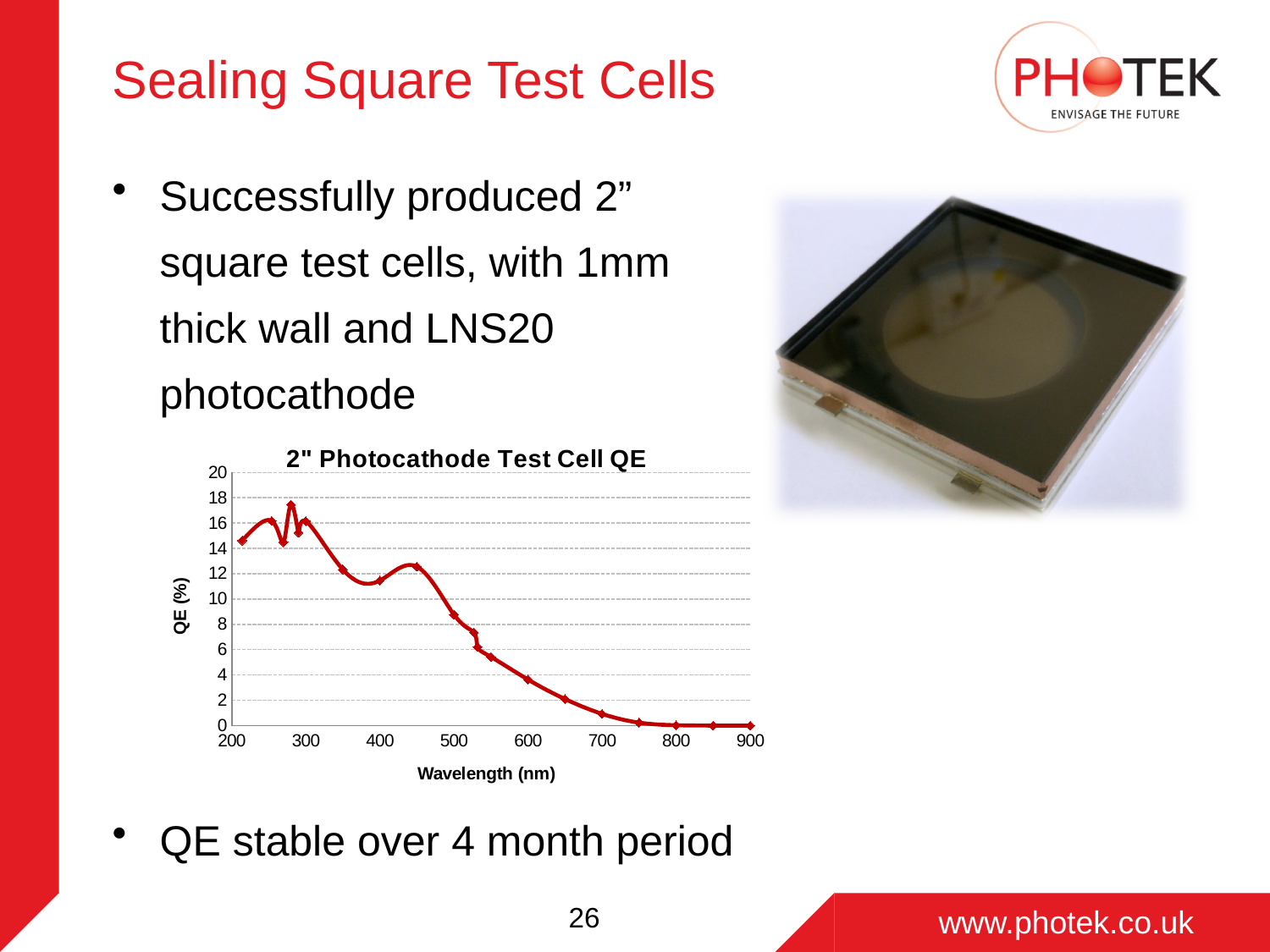
Is the QE value at 800 nm greater or less than 2? less Is the peak QE value near 280 nm greater or less than 16? greater What is the highest value shown on the QE (%) axis? 20 Is the QE value at 700 nm greater or less than 2? less Overall, does the QE rise or fall as wavelength increases from 200 nm to 900 nm? fall What is the label of the x axis of the chart? Wavelength (nm) What is the title of the chart? 2" Photocathode Test Cell QE Is the QE higher at 300 nm or at 600 nm? 300 nm What kind of chart is shown on the slide? line chart